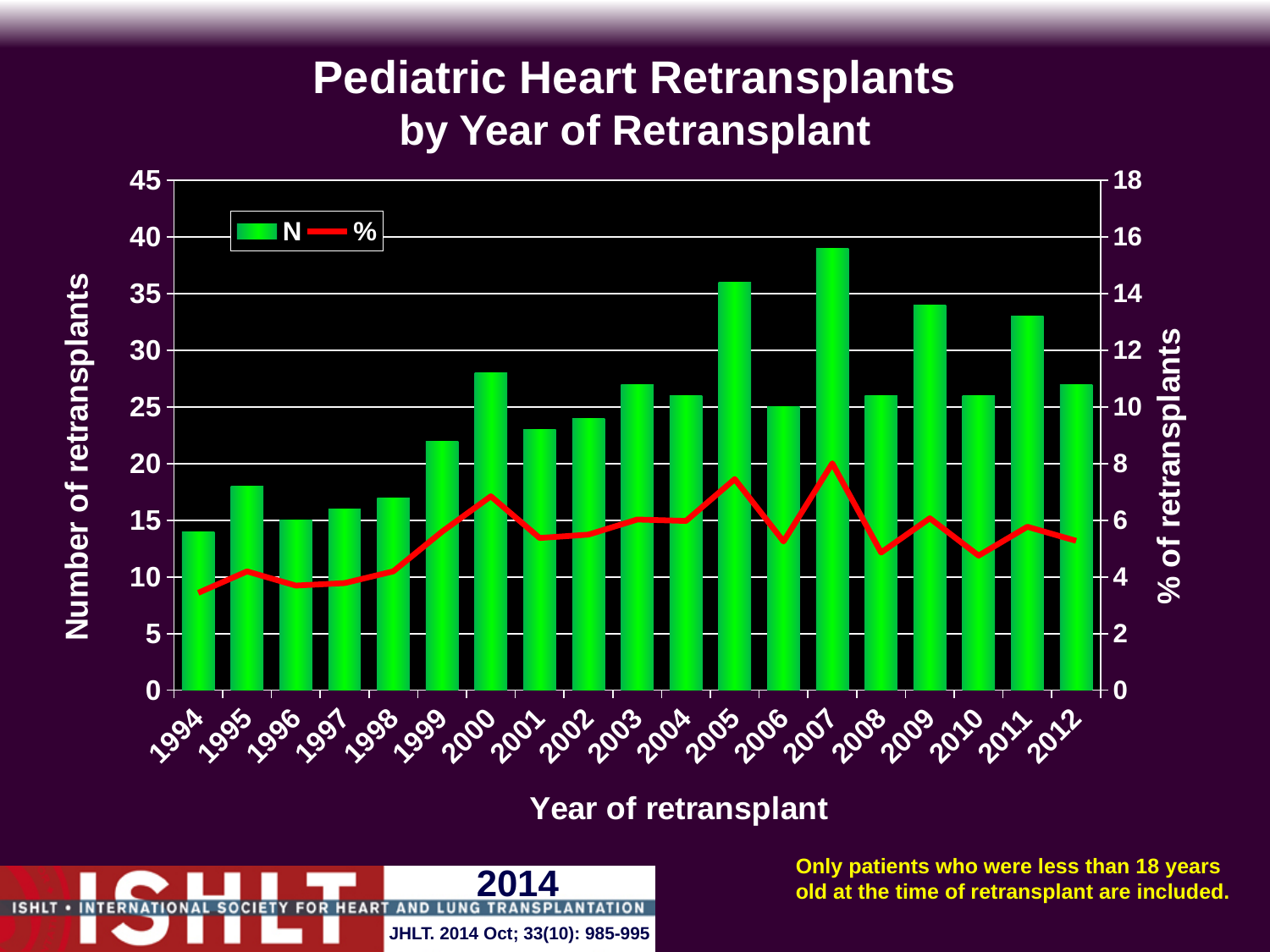
Which year has the highest number of retransplants? 2007 Is the number of retransplants in 2007 greater or less than 35? greater How many years are shown on the x axis? 19 What is the title of the chart? Pediatric Heart Retransplants by Year of Retransplant Which year has more retransplants, 2000 or 2001? 2000 Is the number of retransplants in 2009 greater or less than 30? greater Which year has more retransplants, 2007 or 2011? 2007 What kind of chart is shown on the slide? A bar chart combined with a line In which year does the % of retransplants line reach its highest point? 2007 Is the number of retransplants in 2000 greater or less than 25? greater How many series does the legend list? 2